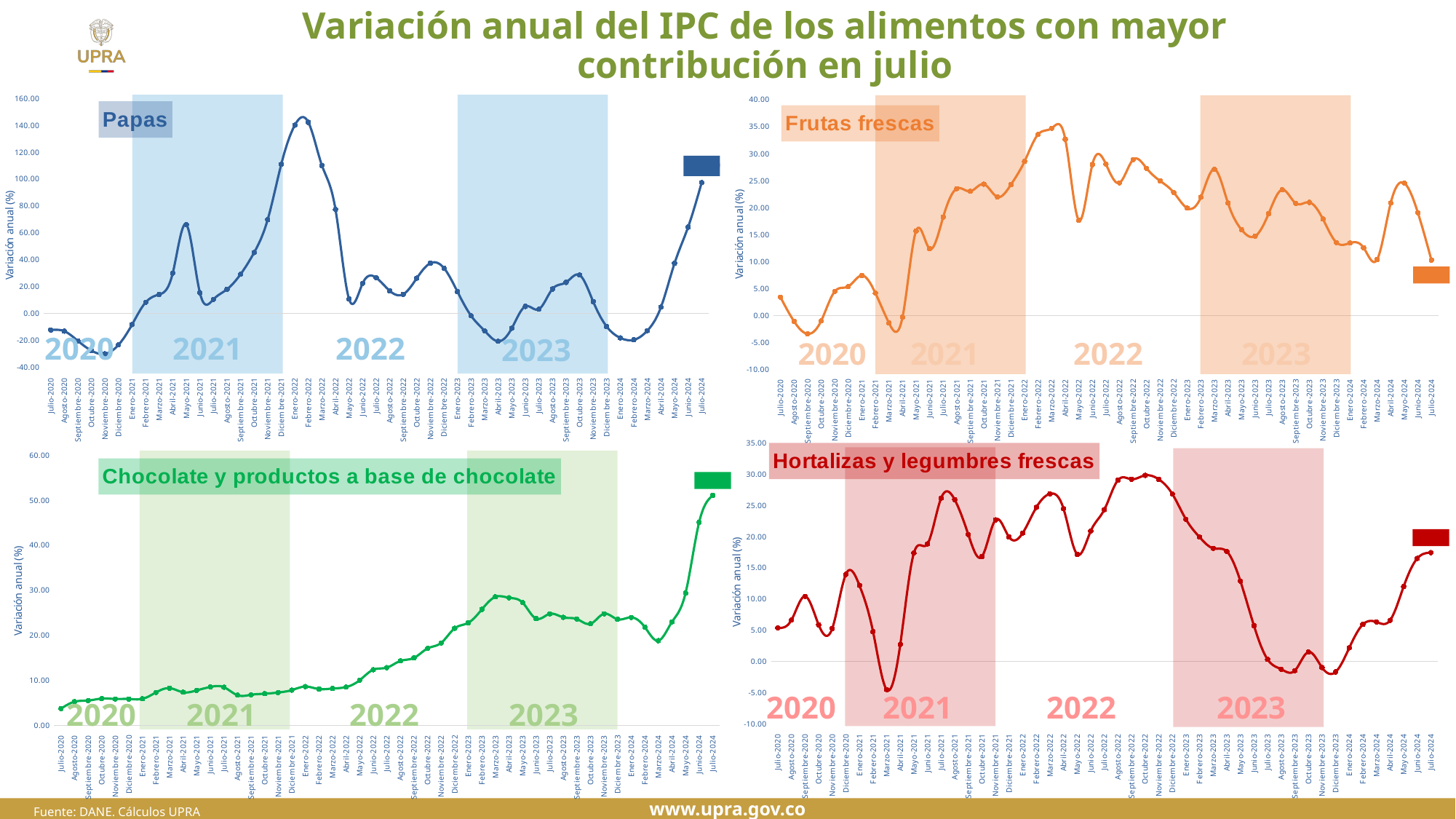
In the Chocolate y productos a base de chocolate chart, is the value for Julio-2024 greater or less than 40? greater How many charts are shown on the slide? 4 In the Chocolate y productos a base de chocolate chart, is the value for Julio-2020 greater or less than 10? less In the Papas chart, is the value for Febrero-2022 greater or less than 120? greater In the Chocolate y productos a base de chocolate chart, do the values rise or fall from Marzo-2024 to Julio-2024? rise What is the label on the vertical axis of the Frutas frescas chart? Variación anual (%) What kind of chart is used for the Papas panel? Line chart